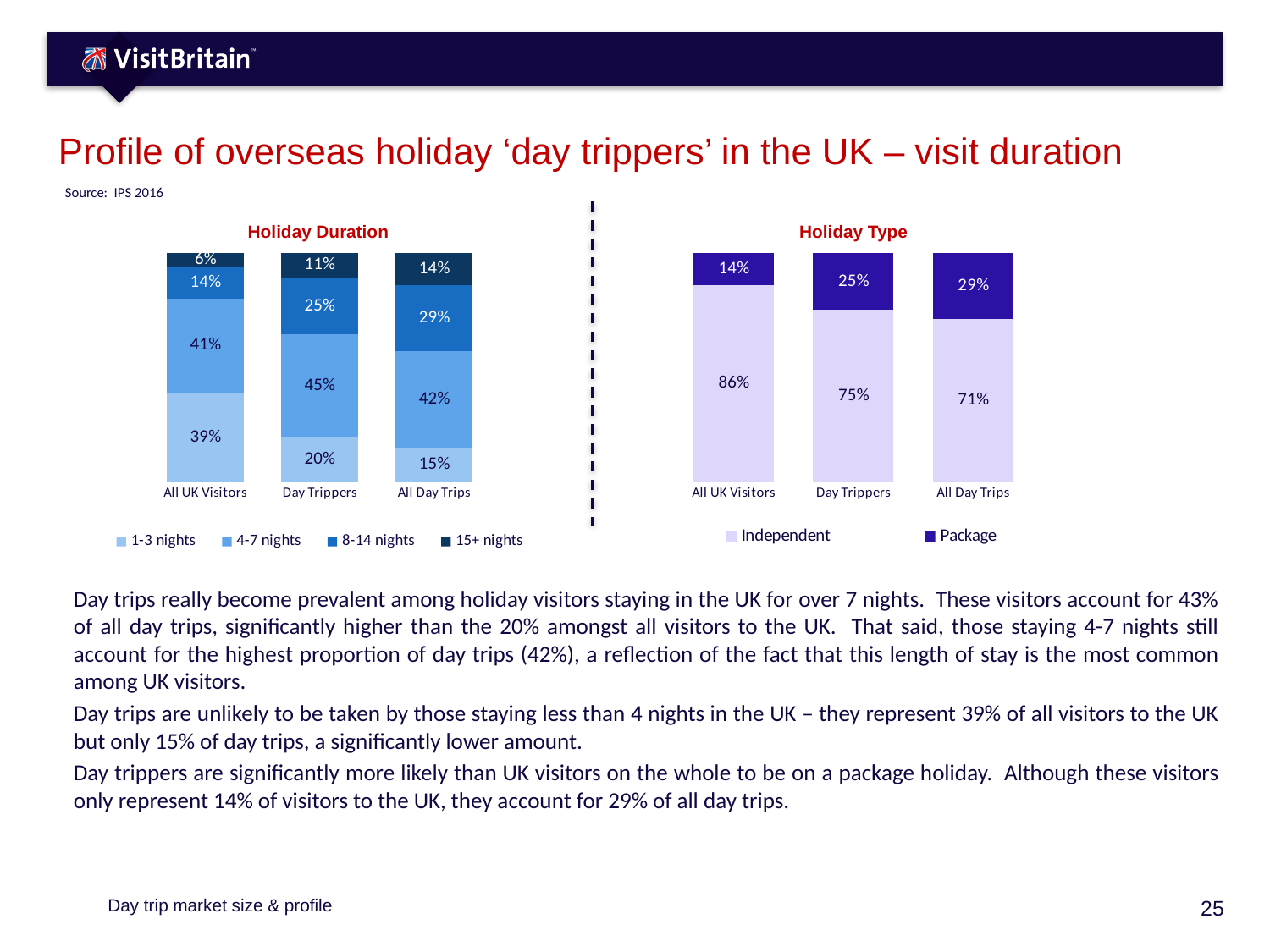
In the Holiday Duration chart, which category has the lowest value for 1-3 nights? All Day Trips In the Holiday Duration chart, what is the combined value of 8-14 nights and 15+ nights for All Day Trips? 43% In the Holiday Duration chart, what is the value for 8-14 nights for All Day Trips? 29% How many categories are shown on the x axis of the Holiday Type chart? 3 In the Holiday Duration chart, what is the value for 1-3 nights for All UK Visitors? 39% In the Holiday Duration chart, what is the value for 4-7 nights for Day Trippers? 45% In the Holiday Type chart, what is the difference between the Package values for All Day Trips and All UK Visitors? 15% In the Holiday Type chart, which category has the highest Independent value? All UK Visitors In the Holiday Type chart, what is the Package value for All Day Trips? 29% In the Holiday Duration chart, which is larger: the 15+ nights value for Day Trippers or for All Day Trips? All Day Trips What kind of chart is the Holiday Type chart? Stacked bar chart How many series does the legend of the Holiday Duration chart list? 4